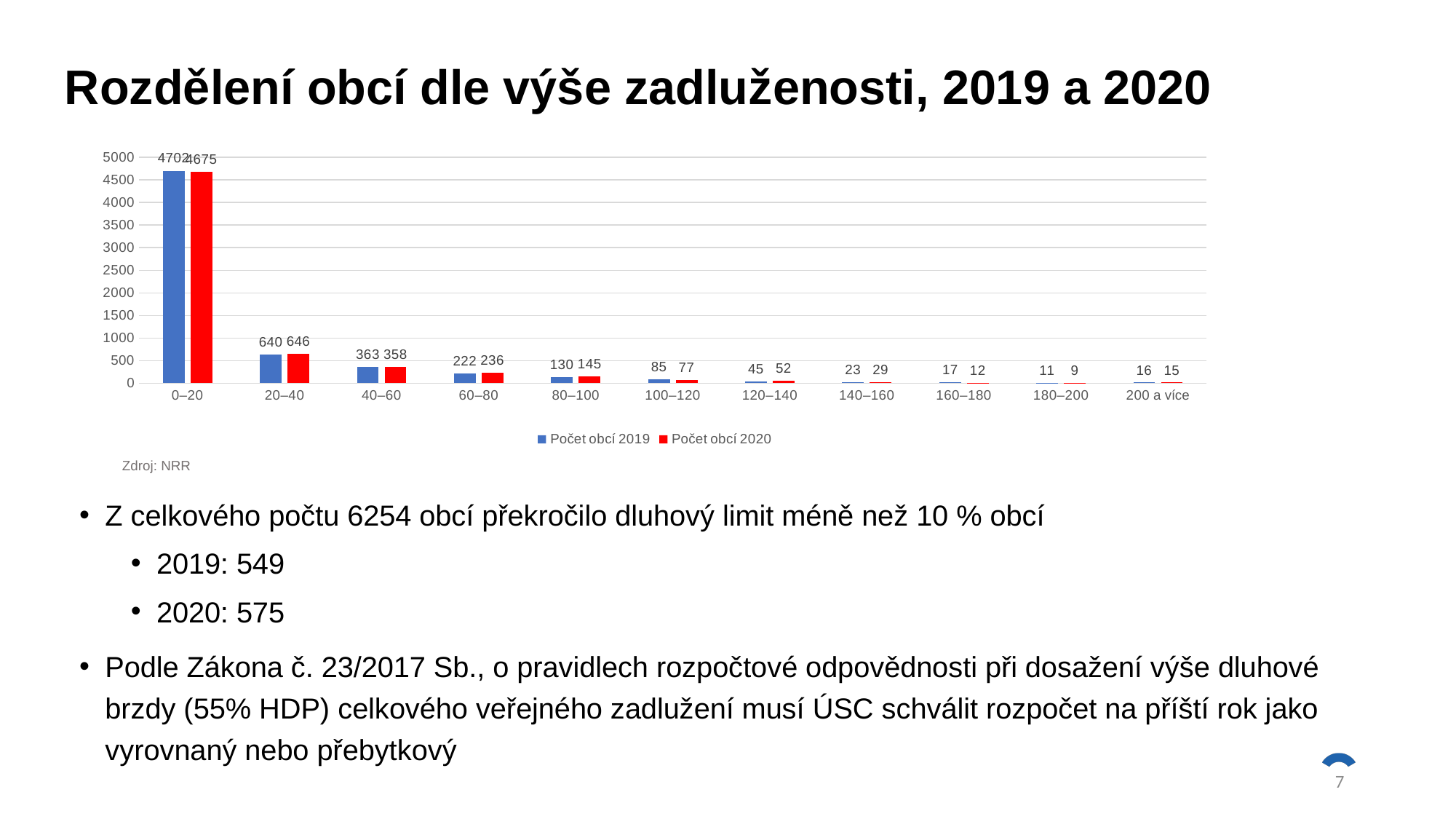
What is the value of Počet obcí 2019 for the 0–20 category? 4702 What colour are the bars for Počet obcí 2020? red Which category has the highest value for Počet obcí 2020? 0–20 Do the values of Počet obcí 2019 generally rise or fall from the 0–20 category to the 180–200 category? fall Which is larger in the 80–100 category, Počet obcí 2019 or Počet obcí 2020? Počet obcí 2020 Which category has the lowest value for Počet obcí 2020? 180–200 What is the value of Počet obcí 2019 for the 200 a více category? 16 What is the value of Počet obcí 2020 for the 60–80 category? 236 How many series does the legend list? 2 How many categories are shown on the x axis? 11 What type of chart is shown on the slide? bar chart What is the difference between Počet obcí 2019 and Počet obcí 2020 in the 0–20 category? 27